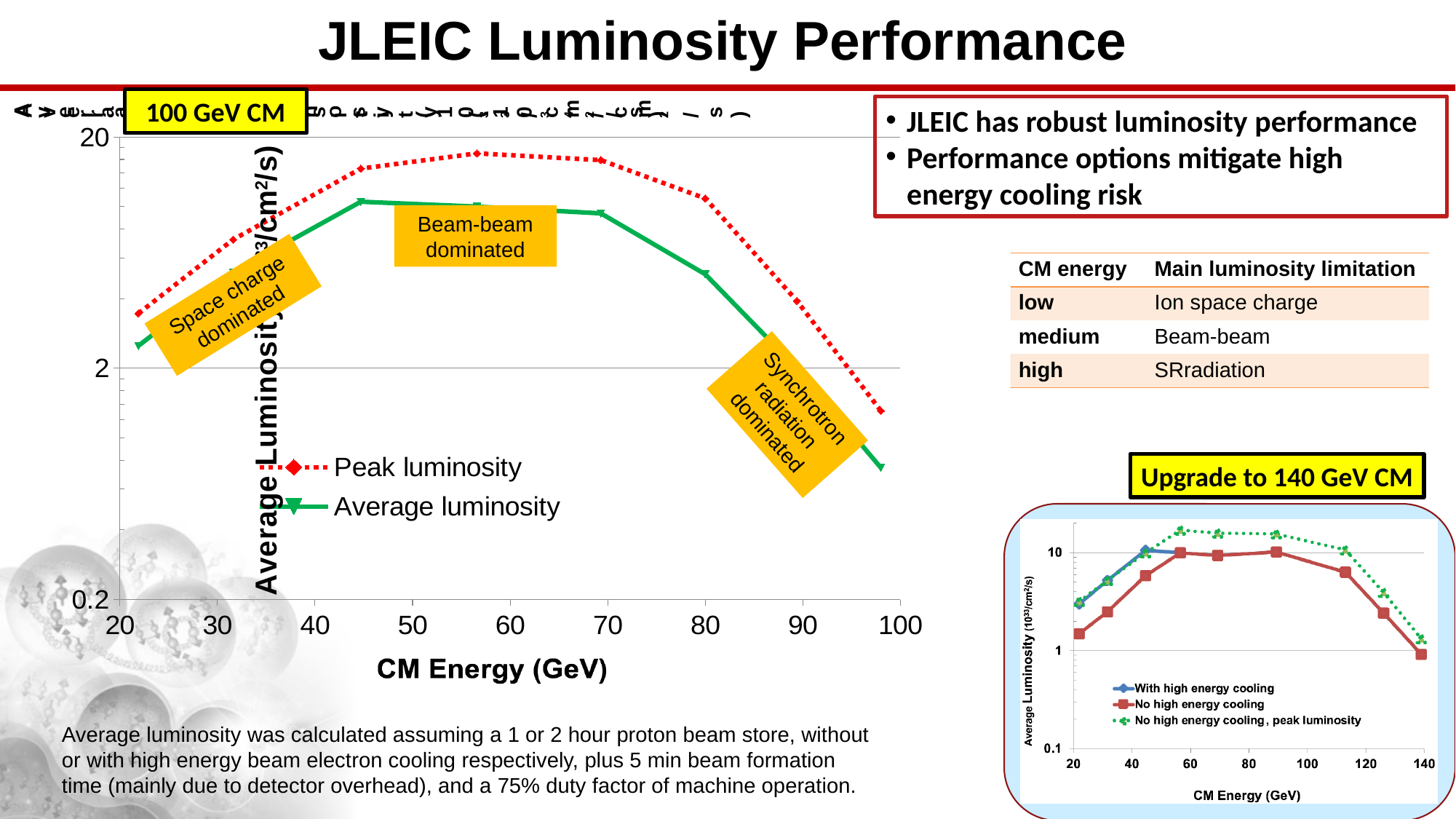
How many series does the legend of the 'Upgrade to 140 GeV CM' chart list? 3 What kind of chart is the large '100 GeV CM' chart on the left? line chart In the large '100 GeV CM' chart, does the Peak luminosity rise or fall as CM energy goes from 20 GeV to 45 GeV? rise What is the x-axis title of the large '100 GeV CM' chart? CM Energy (GeV) In the large '100 GeV CM' chart, which series is higher at 60 GeV, Peak luminosity or Average luminosity? Peak luminosity How many series does the legend of the large '100 GeV CM' chart list? 2 In the large '100 GeV CM' chart, is the Peak luminosity value at 60 GeV greater or less than 20? less In the large '100 GeV CM' chart, is the Peak luminosity value at 100 GeV greater or less than 2? less In the large '100 GeV CM' chart, does the Average luminosity rise or fall as CM energy goes from 60 GeV to 100 GeV? fall In the 'Upgrade to 140 GeV CM' chart, is the 'No high energy cooling, peak luminosity' value at 60 GeV greater or less than 10? greater